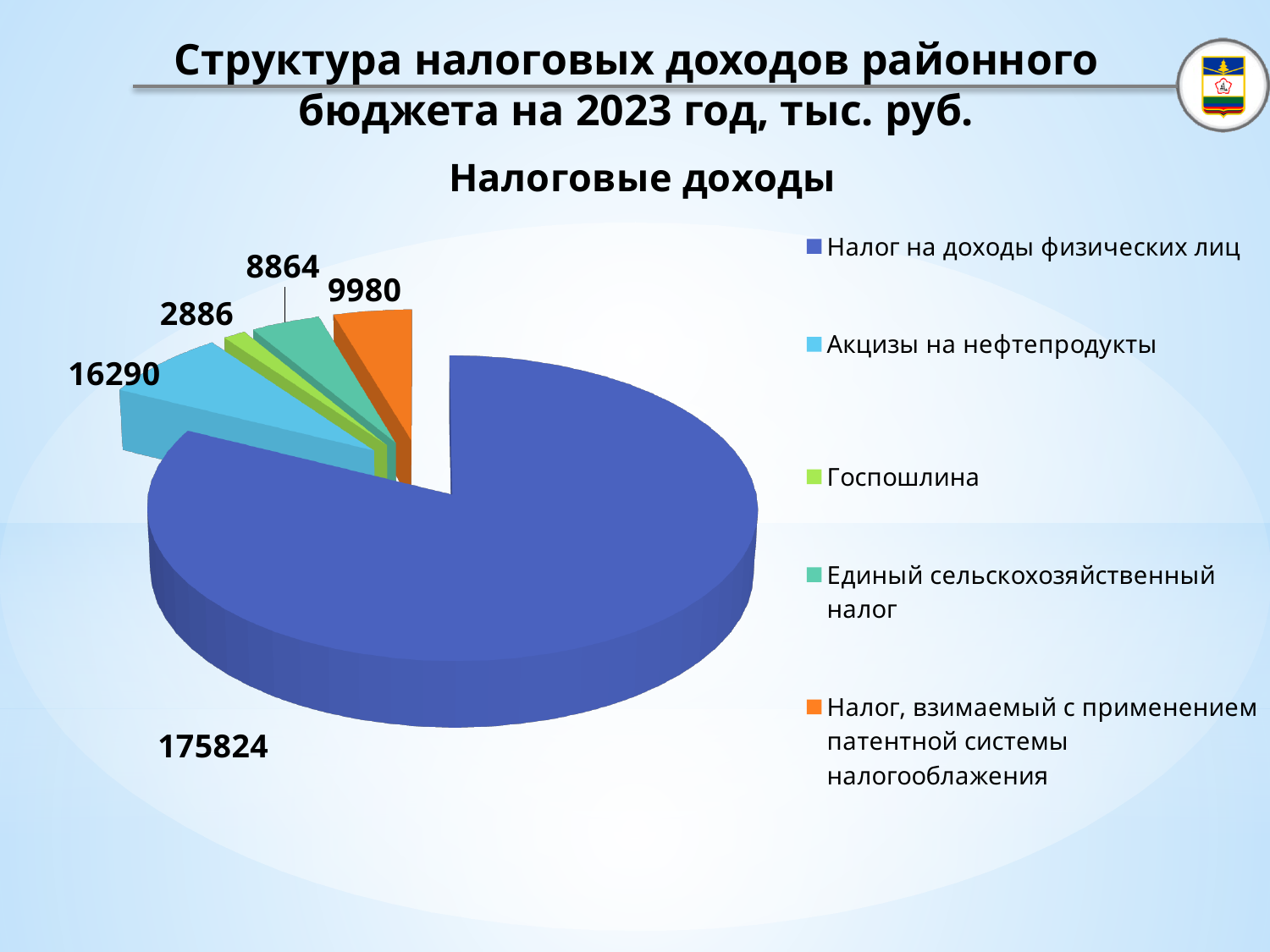
What type of chart is shown on the slide? Pie chart What is the title of the chart? Налоговые доходы What is the value for Акцизы на нефтепродукты? 16290 Which category has the largest slice of the pie? Налог на доходы физических лиц What is the value for Налог, взимаемый с применением патентной системы налогооблажения? 9980 What is the value for Налог на доходы физических лиц? 175824 What is the value for Единый сельскохозяйственный налог? 8864 Which is larger: Единый сельскохозяйственный налог or Налог, взимаемый с применением патентной системы налогооблажения? Налог, взимаемый с применением патентной системы налогооблажения Which category has the smallest slice of the pie? Госпошлина What is the difference between the values for Акцизы на нефтепродукты and Налог, взимаемый с применением патентной системы налогооблажения? 6310 How many categories does the pie chart show? 5 What is the value for Госпошлина? 2886